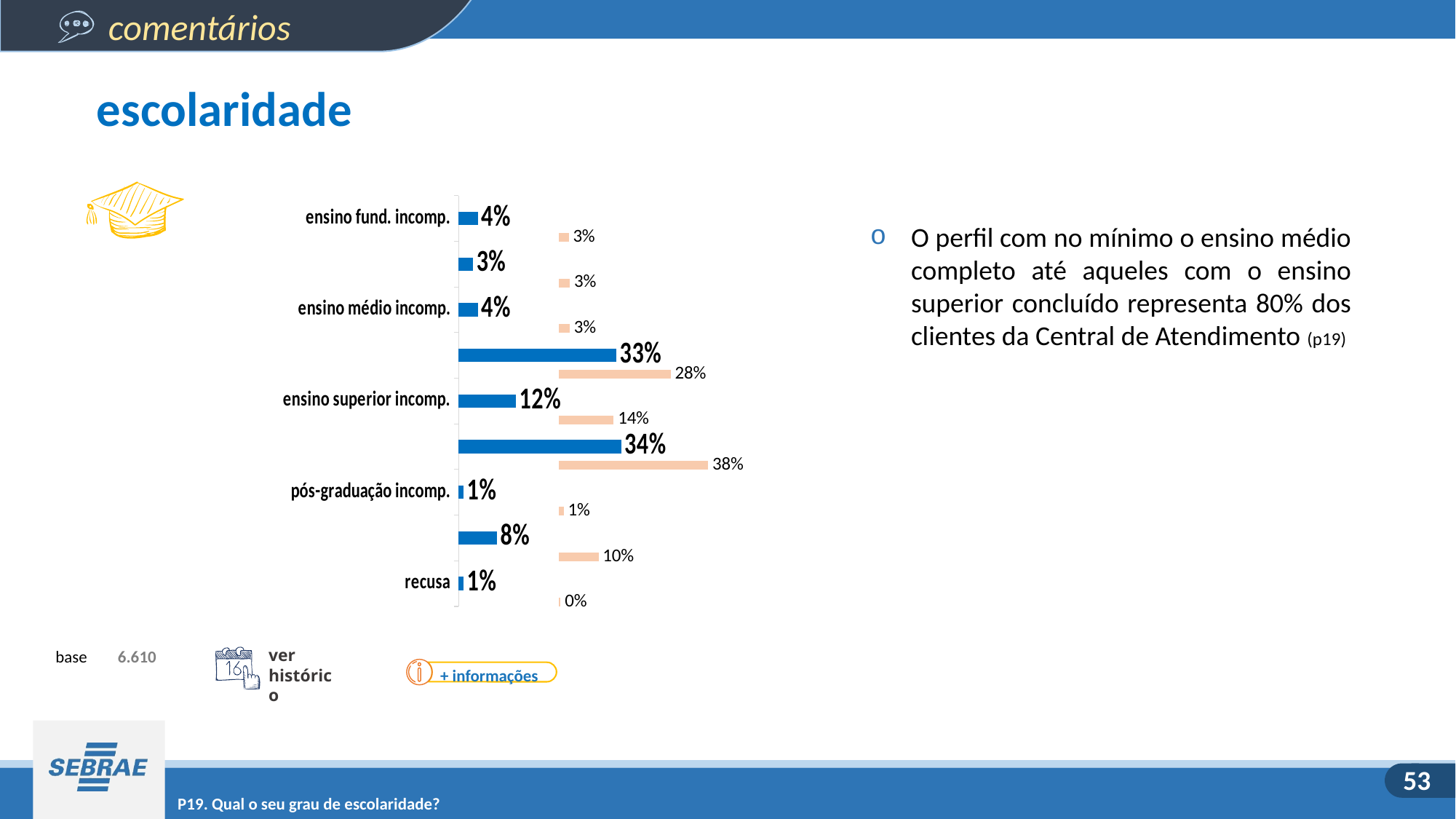
How many blue bars are plotted in the chart? 9 What is the value of the blue bar for 'pós-graduação incomp.'? 1% For 'ensino superior incomp.', which is larger: the blue bar or the light orange bar? the light orange bar What is the highest value shown among the light orange bars? 38% What is the value of the blue bar for 'ensino fund. incomp.'? 4% What is the value of the light orange bar for 'ensino médio incomp.'? 3% What is the value of the light orange bar for 'recusa'? 0% What is the highest value shown among the blue bars? 34% What is the value of the light orange bar for 'ensino superior incomp.'? 14% What kind of chart is shown on the slide? bar chart What is the difference between the light orange and blue values for 'ensino superior incomp.'? 2% What is the value of the blue bar for 'ensino superior incomp.'? 12%